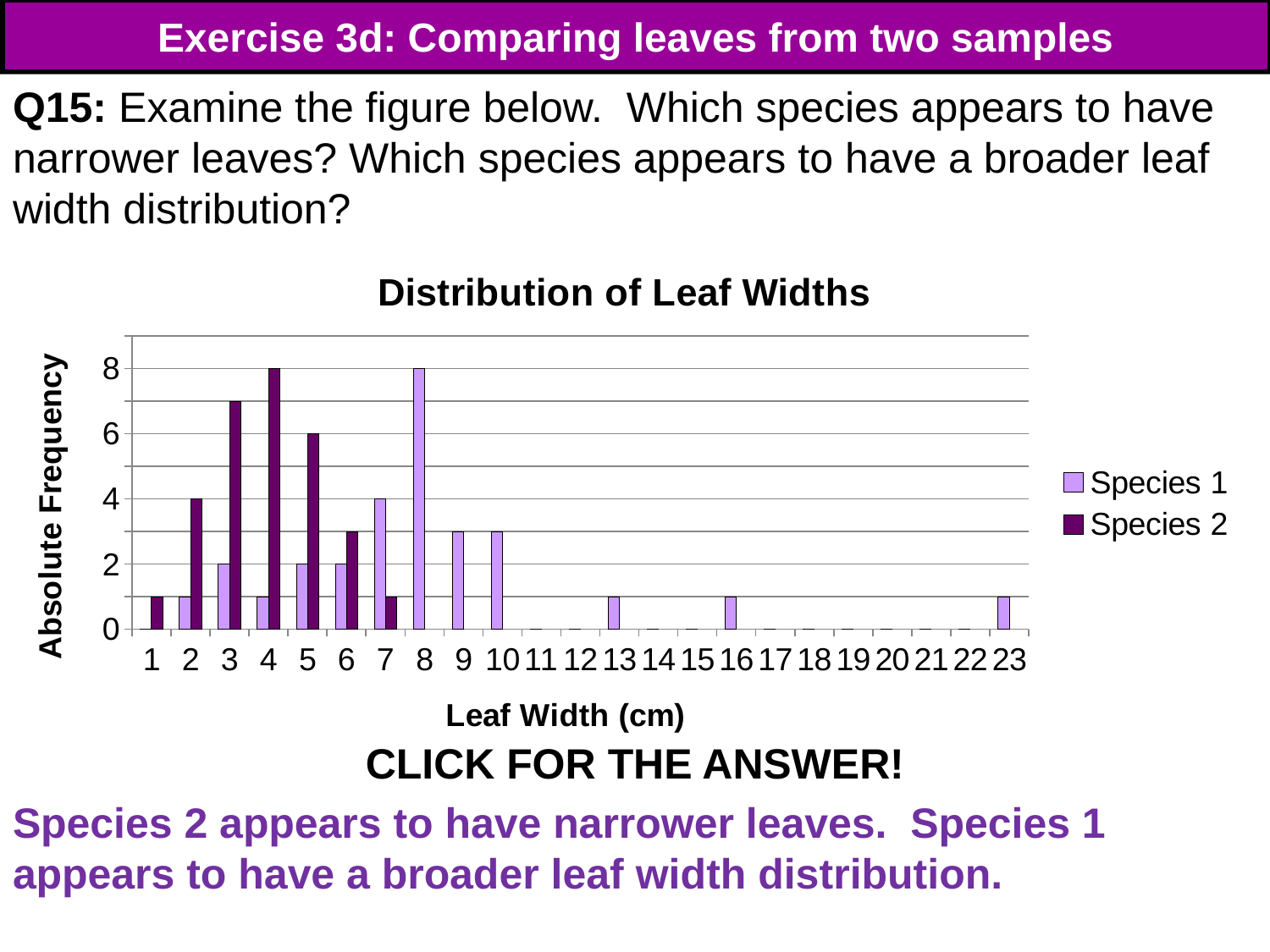
What is the absolute frequency for Species 2 at a leaf width of 5 cm? 6 What kind of chart is shown on the slide? bar chart At which leaf width does Species 2 have its highest frequency? 4 How many series does the legend list? 2 What is the absolute frequency for Species 1 at a leaf width of 8 cm? 8 At a leaf width of 3 cm, which species has the higher frequency? Species 2 At which leaf width does Species 1 have its highest frequency? 8 What is the title of the chart? Distribution of Leaf Widths What is the difference between the Species 1 frequency at 8 cm and at 7 cm? 4 How many leaf width categories are shown on the x axis? 23 Is the frequency for Species 2 at a leaf width of 3 cm greater or less than 6? greater What is the absolute frequency for Species 2 at a leaf width of 4 cm? 8